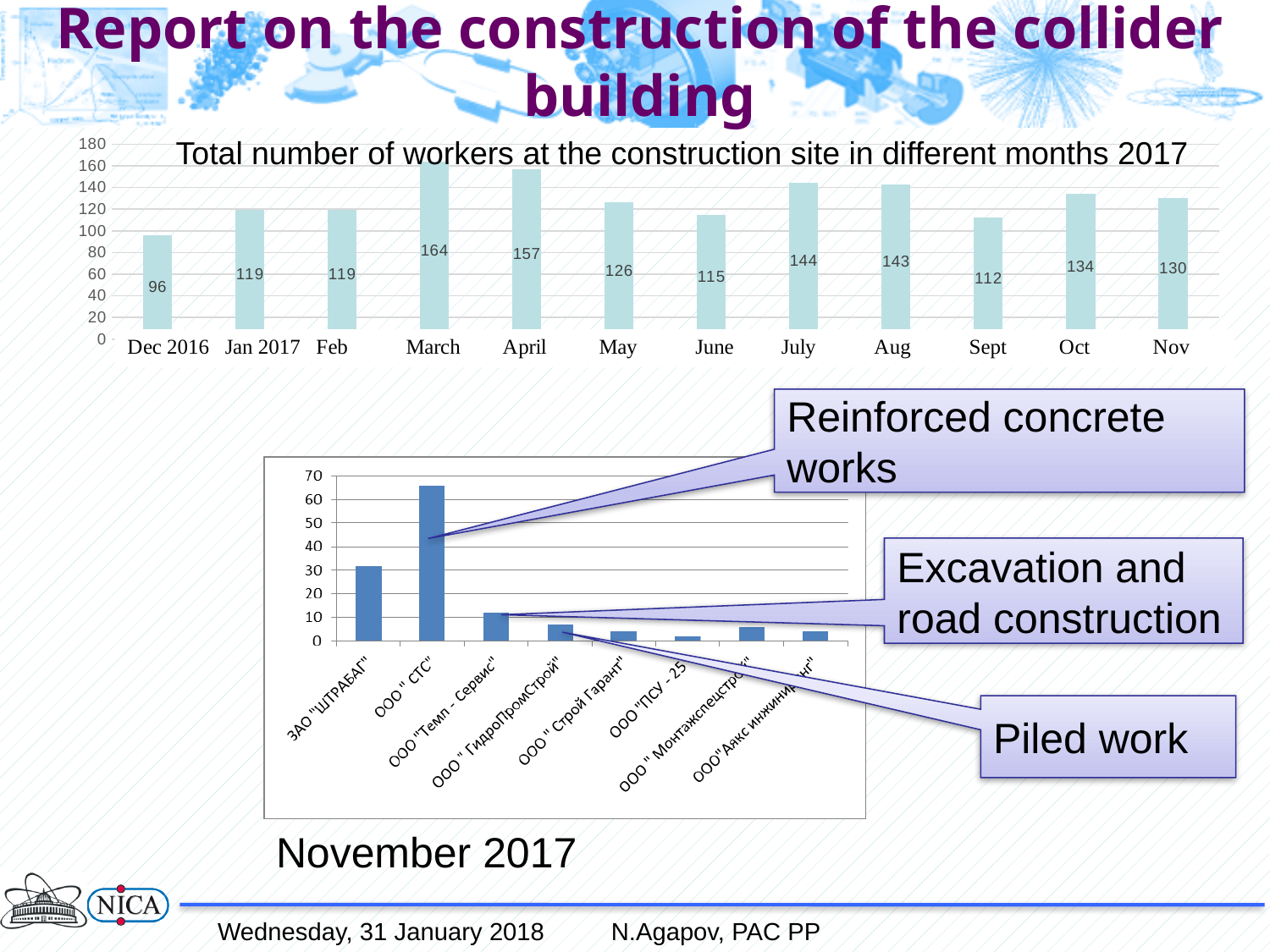
In the top chart 'Total number of workers at the construction site in different months 2017', which month had more workers, July or Oct? July In the top chart 'Total number of workers at the construction site in different months 2017', did the number of workers rise or fall from March to June? fall In the top chart 'Total number of workers at the construction site in different months 2017', what was the total number of workers in Dec 2016? 96 In the bottom chart for November 2017, is the value for ООО "СТС" greater or less than 60? greater In the top chart 'Total number of workers at the construction site in different months 2017', how many months are shown on the x axis? 12 What kind of chart is the bottom chart on the slide showing the companies for November 2017? bar chart In the top chart 'Total number of workers at the construction site in different months 2017', which month had the lowest number of workers? Dec 2016 In the top chart 'Total number of workers at the construction site in different months 2017', which month had the highest number of workers? March In the top chart 'Total number of workers at the construction site in different months 2017', what is the difference between the number of workers in March and in Sept? 52 In the top chart 'Total number of workers at the construction site in different months 2017', what was the total number of workers in March? 164 In the bottom chart for November 2017, is the value for ЗАО "ШТРАБАГ" greater or less than 40? less In the bottom chart for November 2017, which company has the highest bar? ООО "СТС"